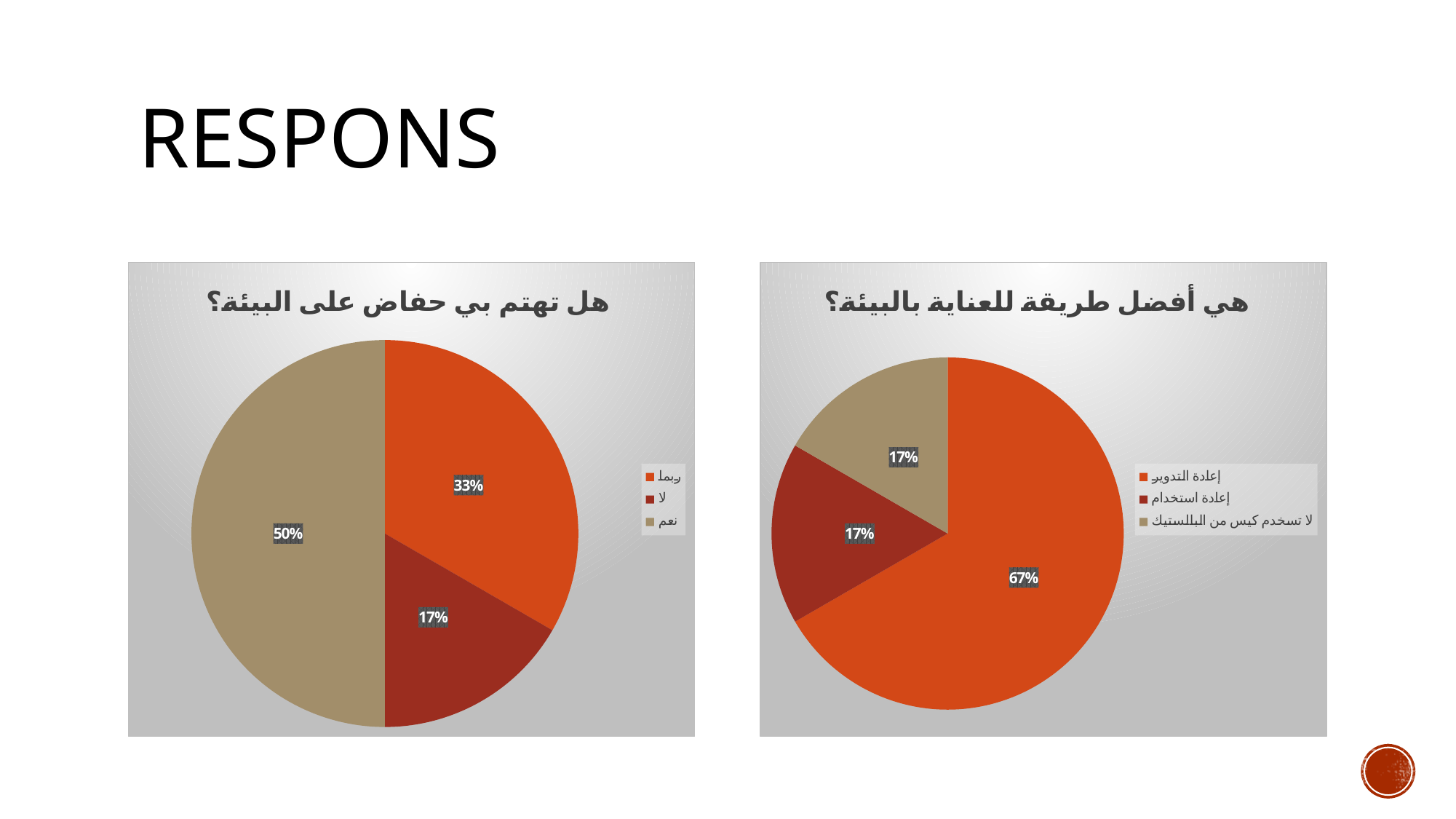
In the right chart ("هي أفضل طريقة للعناية بالبيئة؟"), what share of the pie is "إعادة استخدام"? 17% How many categories does the legend of the right chart ("هي أفضل طريقة للعناية بالبيئة؟") list? 3 In the right chart ("هي أفضل طريقة للعناية بالبيئة؟"), what colour is the "إعادة التدوير" slice? Orange In the left chart ("هل تهتم بي حفاض على البيئة؟"), what share of the pie is "نعم"? 50% In the right chart ("هي أفضل طريقة للعناية بالبيئة؟"), which category has the largest slice? إعادة التدوير In the right chart ("هي أفضل طريقة للعناية بالبيئة؟"), what share of the pie is "إعادة التدوير"? 67% In the left chart ("هل تهتم بي حفاض على البيئة؟"), which category has the largest slice? نعم What kind of chart is the left chart titled "هل تهتم بي حفاض على البيئة؟"? Pie chart In the left chart ("هل تهتم بي حفاض على البيئة؟"), what is the difference in percentage points between "نعم" and "ربما"? 17 In the left chart ("هل تهتم بي حفاض على البيئة؟"), which category has the smallest slice? لا